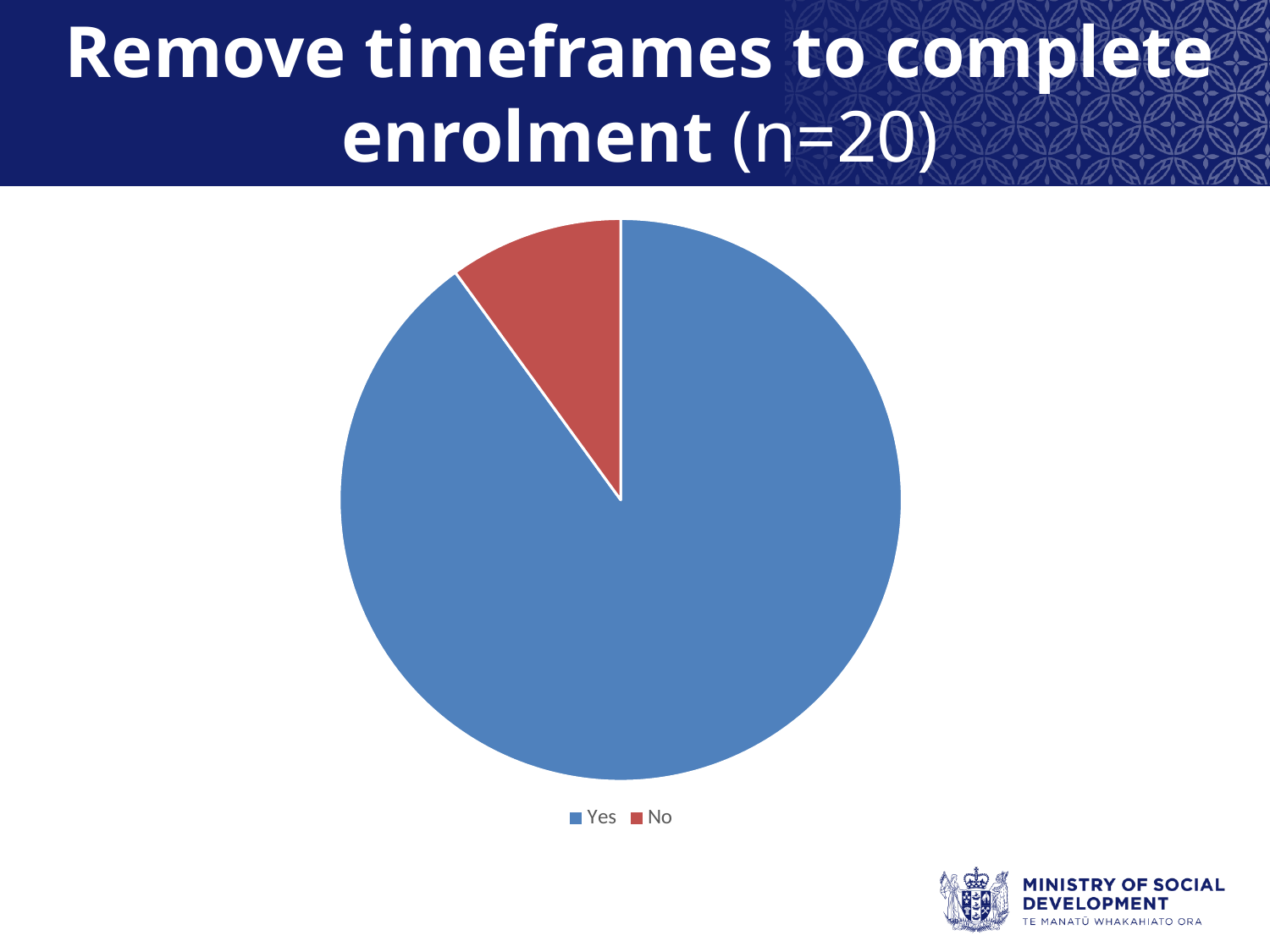
What colour is the No slice in the pie chart? Red Which slice is larger, Yes or No? Yes What is the title of the chart? Remove timeframes to complete enrolment (n=20) What kind of chart is shown on the slide? Pie chart Which category has the smallest slice of the pie? No How many entries does the legend list? 2 Which category has the largest slice of the pie? Yes Does the Yes slice take up more or less than half of the pie? More How many slices does the pie chart have? 2 What are the two categories listed in the legend? Yes and No